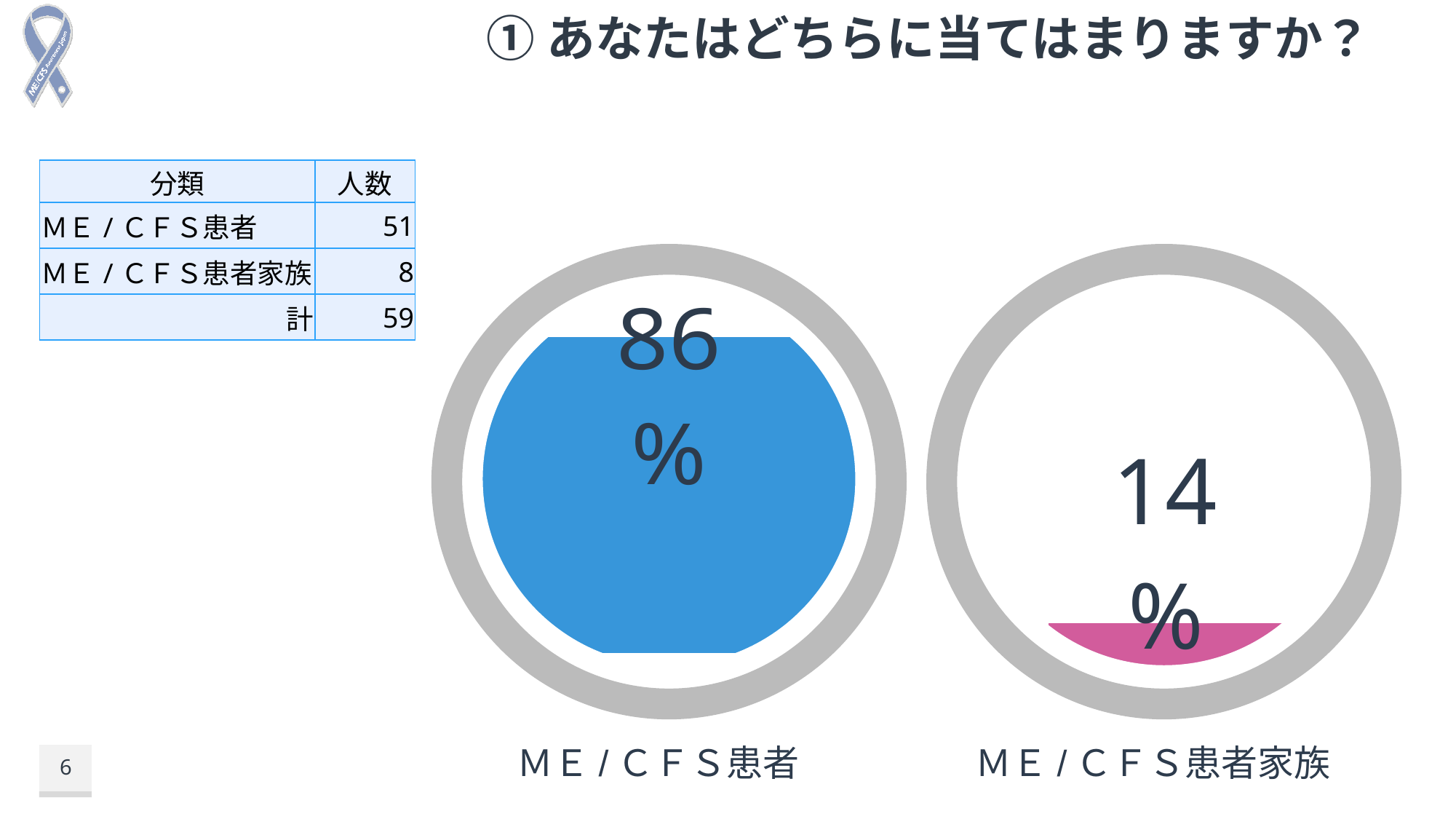
According to the table on the slide, how many people are ME／CFS患者家族? 8 What percentage is shown in the left circle chart labelled ME／CFS患者? 86% Is the percentage in the ME／CFS患者家族 circle chart larger or smaller than the percentage in the ME／CFS患者 circle chart? smaller What percentage is shown in the right circle chart labelled ME／CFS患者家族? 14% According to the table on the slide, what is the total number of respondents (計)? 59 What colour is the filled portion of the ME／CFS患者 circle chart? blue What colour is the filled portion of the ME／CFS患者家族 circle chart? pink Which of the two circle charts shows the higher percentage, ME／CFS患者 or ME／CFS患者家族? ME／CFS患者 What is the difference in percentage points between the ME／CFS患者 circle chart and the ME／CFS患者家族 circle chart? 72 Which of the two circle charts shows the lower percentage, ME／CFS患者 or ME／CFS患者家族? ME／CFS患者家族 According to the table on the slide, how many people are ME／CFS患者? 51 How many circle charts are shown on the slide? 2